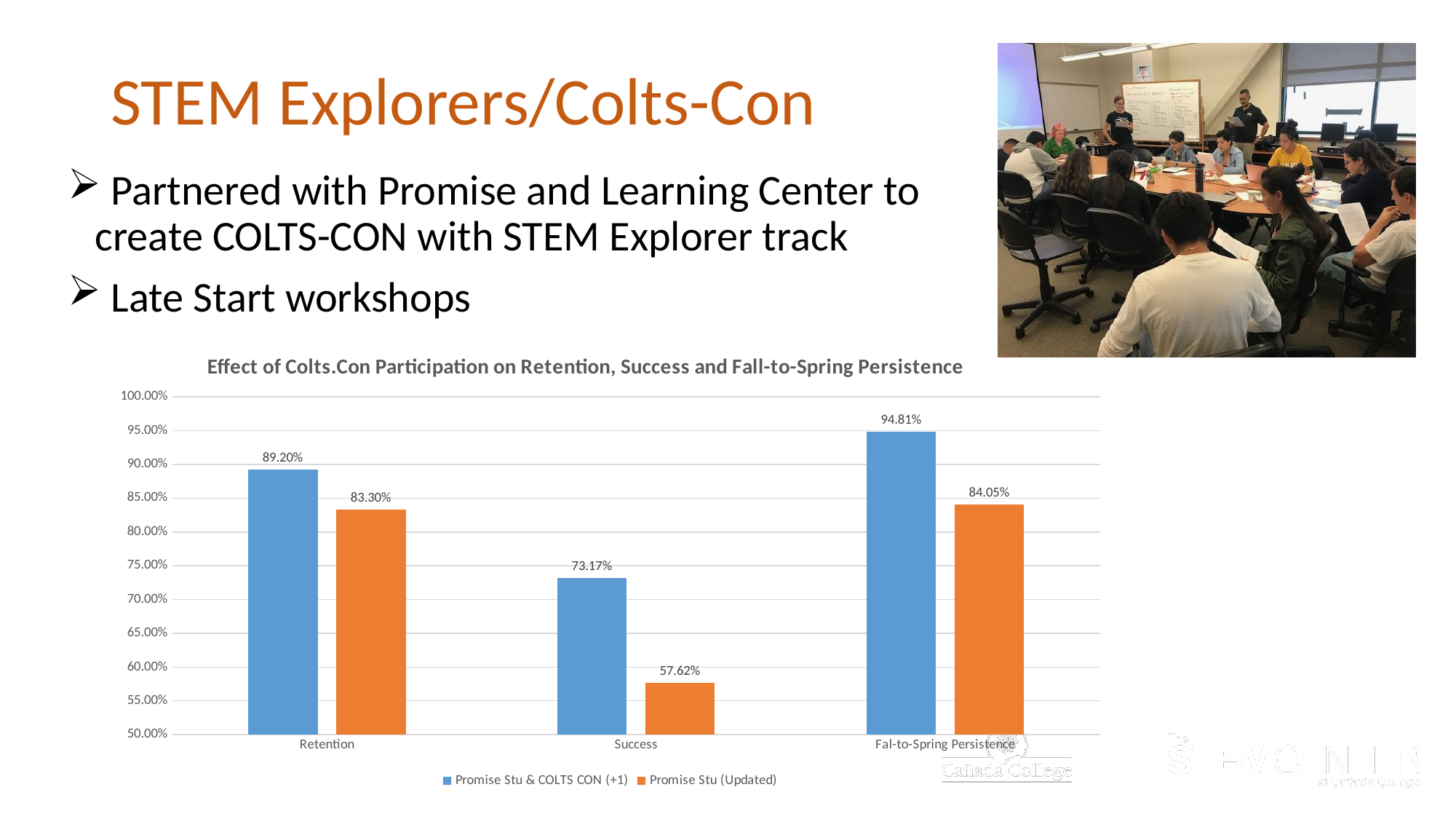
What is the value for Promise Stu (Updated) in the Success category? 57.62% What is the value for Promise Stu & COLTS CON (+1) in the Retention category? 89.20% What is the difference between the Promise Stu & COLTS CON (+1) and Promise Stu (Updated) values in the Success category? 15.55% What is the value for Promise Stu & COLTS CON (+1) in the Fal-to-Spring Persistence category? 94.81% What is the difference between the two series' values in the Fal-to-Spring Persistence category? 10.76% Which category has the lowest value for the Promise Stu (Updated) series? Success How many categories are shown on the x axis of the chart? 3 What type of chart is shown on the slide? Bar chart In the Retention category, which series has the larger value? Promise Stu & COLTS CON (+1) How many series does the chart legend list? 2 What is the value for Promise Stu (Updated) in the Retention category? 83.30% Which category has the highest value for the Promise Stu & COLTS CON (+1) series? Fal-to-Spring Persistence